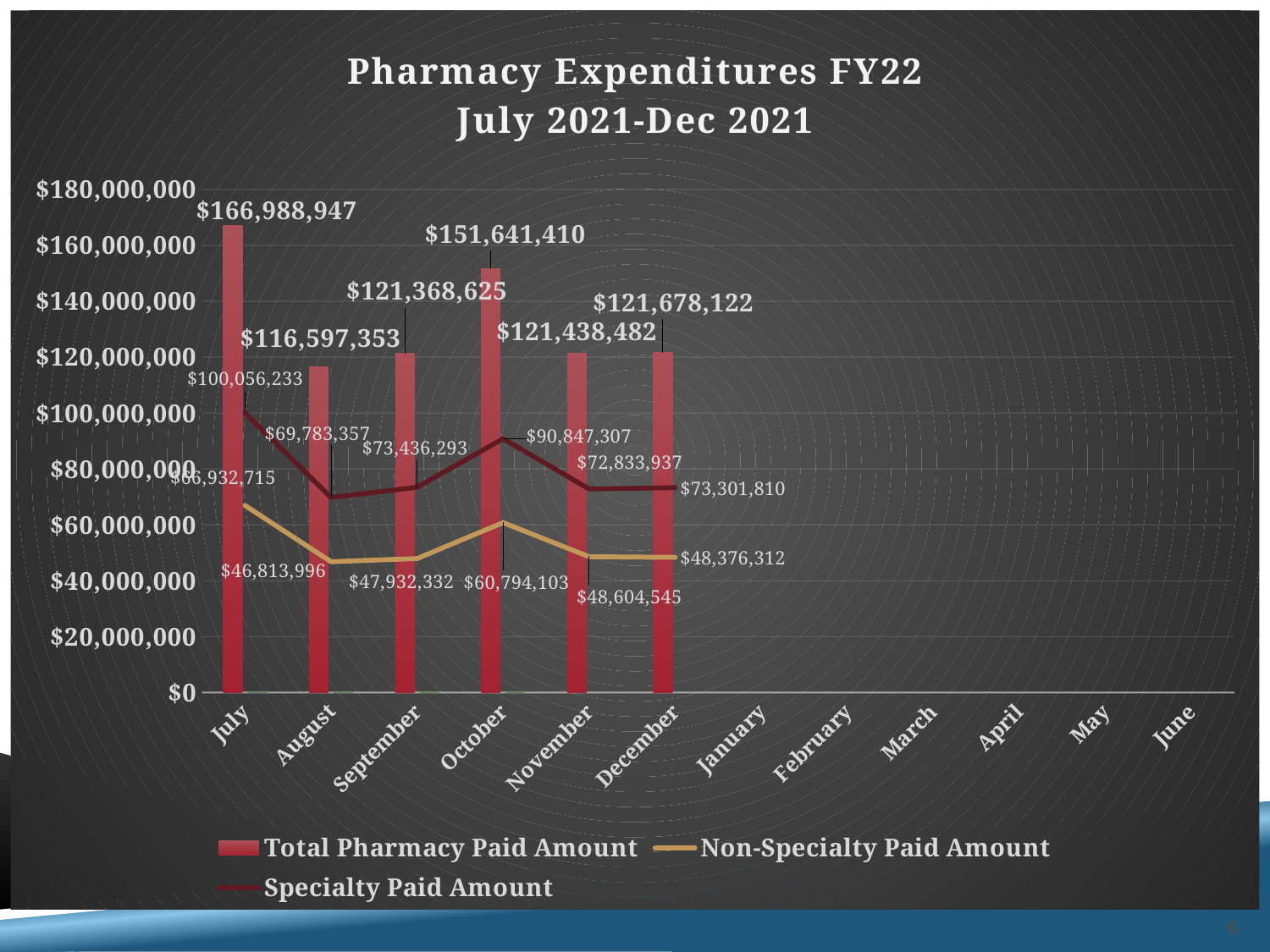
Does the Total Pharmacy Paid Amount rise or fall from July to August? fall Which month has the lowest Total Pharmacy Paid Amount among the months with data? August Which month has the highest Total Pharmacy Paid Amount? July Which is larger in October, the Specialty Paid Amount or the Non-Specialty Paid Amount? Specialty Paid Amount What is the Specialty Paid Amount for October? $90,847,307 How many series does the legend list? 3 What is the Non-Specialty Paid Amount for October? $60,794,103 How many months have a Total Pharmacy Paid Amount bar plotted? 6 Which month has the lowest Specialty Paid Amount among the months with data? August Is the Total Pharmacy Paid Amount for October greater or less than $140,000,000? greater What is the Total Pharmacy Paid Amount for July? $166,988,947 What is the difference between the Total Pharmacy Paid Amount for July and for October? $15,347,537